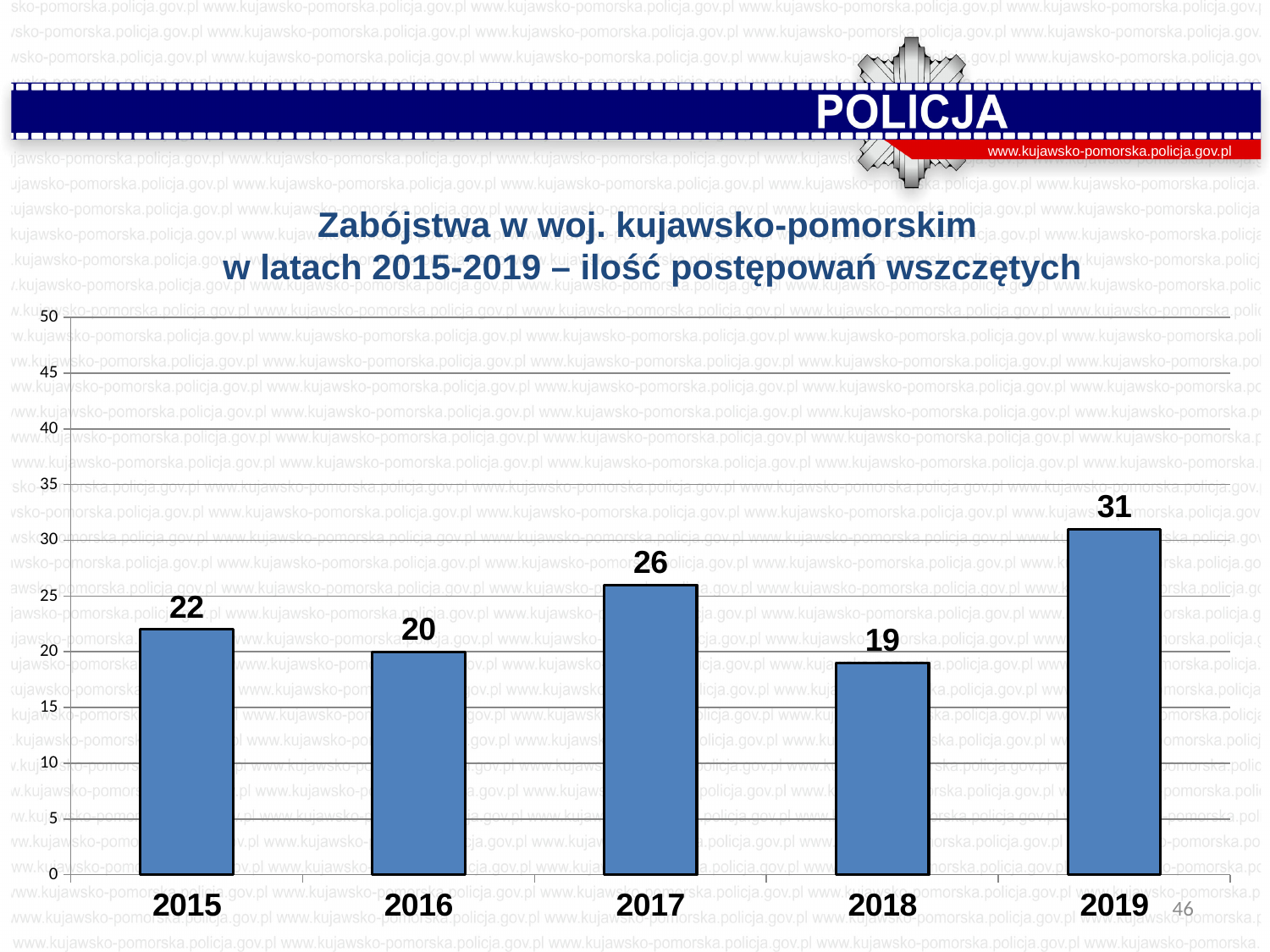
Which is larger, the value for 2015 or the value for 2016? 2015 What is the value for 2015? 22 Which year has the lowest value? 2018 Which year has the highest value? 2019 How many years are shown on the chart? 5 What kind of chart is shown on the slide? bar chart What is the title of the chart? Zabójstwa w woj. kujawsko-pomorskim w latach 2015-2019 – ilość postępowań wszczętych What is the difference between the values for 2019 and 2018? 12 Is the value for 2017 greater or less than 25? greater What is the difference between the values for 2017 and 2016? 6 What is the value for 2018? 19 What is the value for 2019? 31